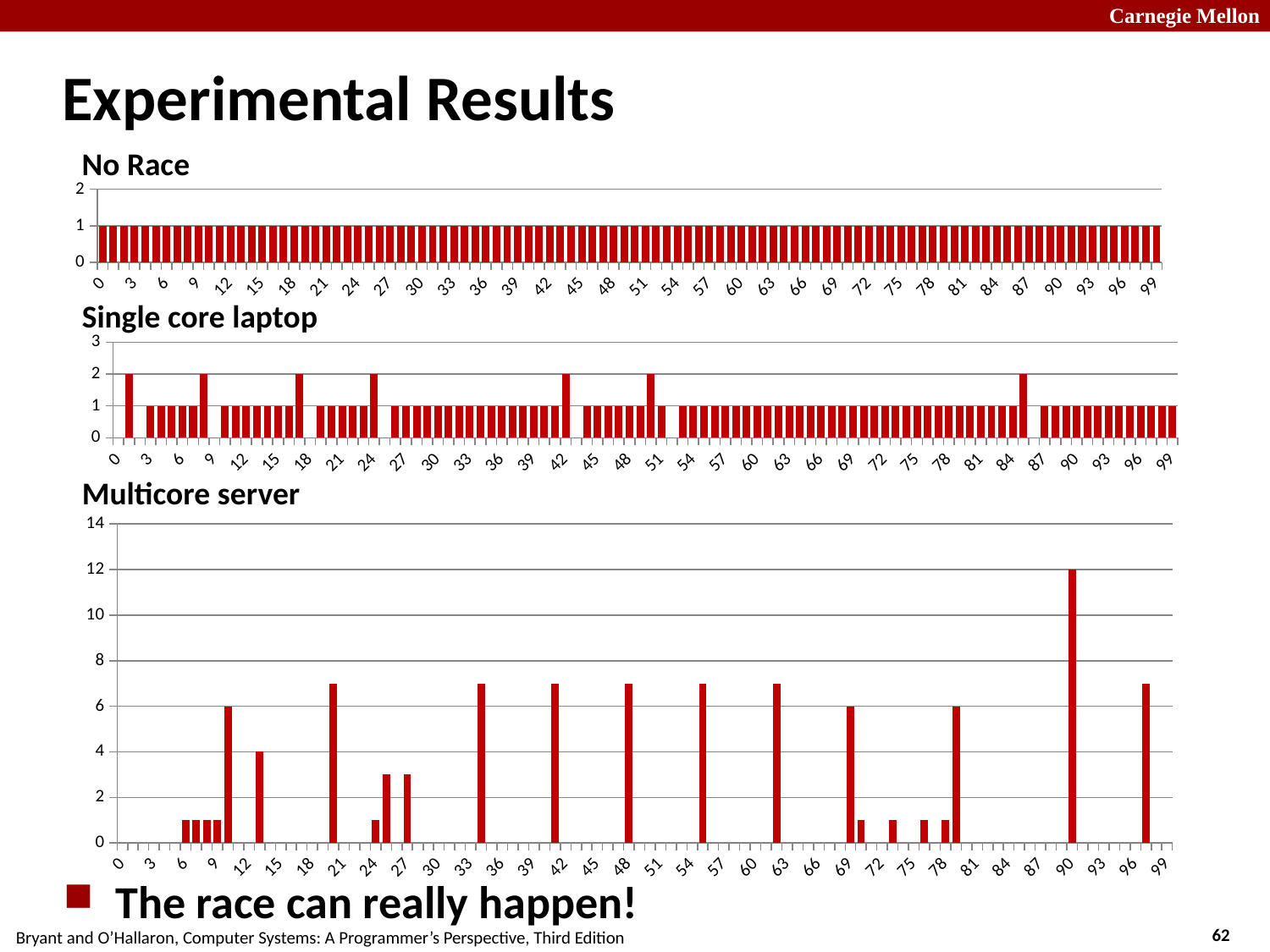
In the Multicore server chart, is the value at x = 0 greater or less than 2? less Which chart has the higher maximum bar value, Single core laptop or Multicore server? Multicore server How many charts are shown on the slide? 3 In the No Race chart, do the values rise, fall, or stay constant along the x axis? stay constant What kind of chart is the Multicore server chart? bar chart In the Multicore server chart, is the tallest bar greater or less than 10? greater In the Single core laptop chart, what is the highest value reached by any bar? 2 What is the top value on the y axis of the Multicore server chart? 14 In the Multicore server chart, which x-axis category has the tallest bar? 90 In the No Race chart, what value do all the bars have? 1 What is the difference between the maximum bar value in the Multicore server chart and the maximum bar value in the Single core laptop chart? 10 In the Multicore server chart, what is the highest value reached by any bar? 12